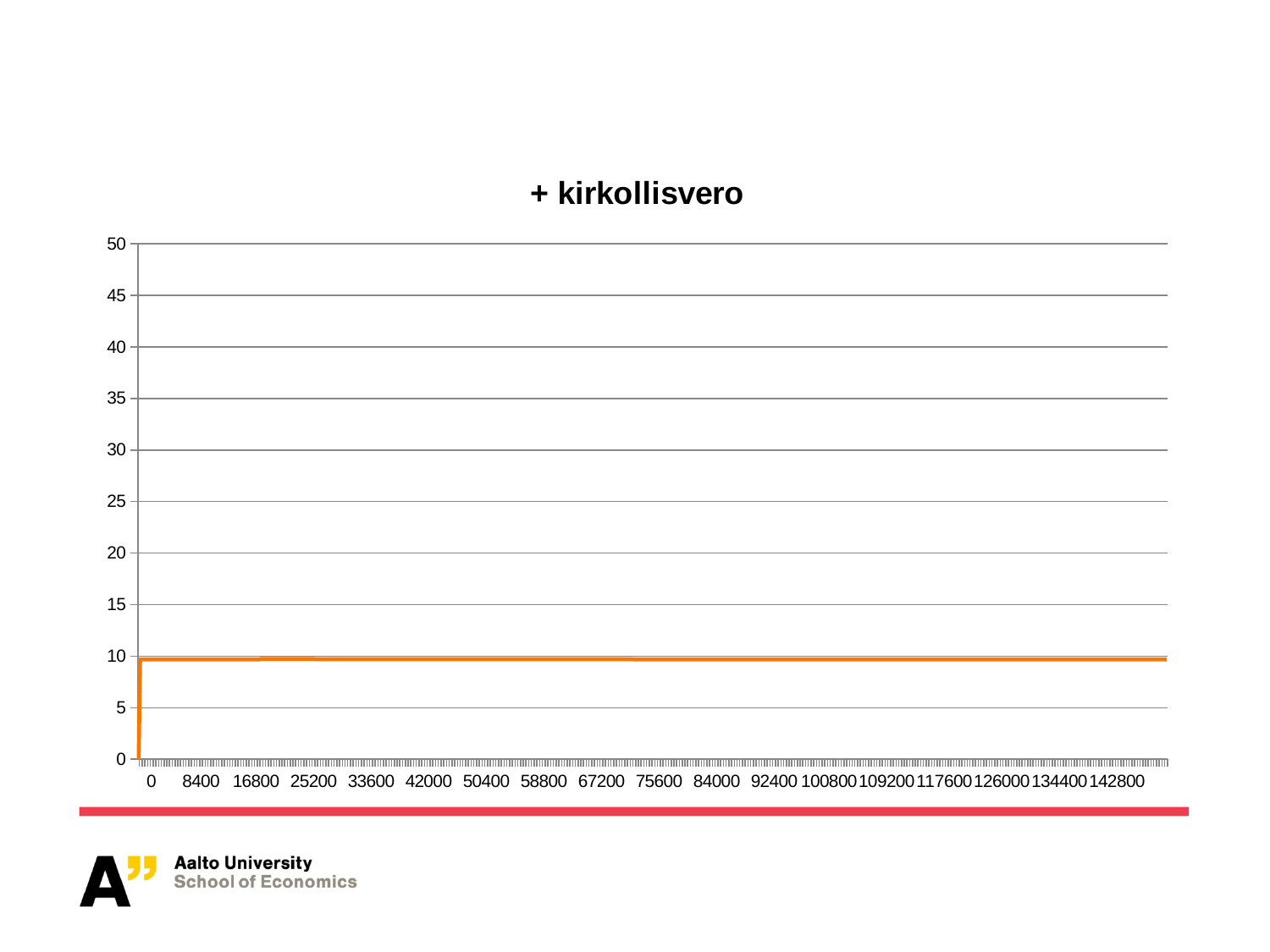
How many labelled tick values are shown on the x axis? 18 Is the value for 142800 greater or less than 20? less Is the value for 16800 greater or less than 25? less Is the value for 42000 greater or less than 5? greater What is the last labelled value on the x axis? 142800 What is the highest value shown on the y axis? 50 After the initial jump at 0, does the line rise, fall or stay flat along the x axis? stay flat What kind of chart is shown on the slide? line chart What is the step between consecutive y-axis labels? 5 What is the title of the chart? + kirkollisvero What colour is the plotted line? orange